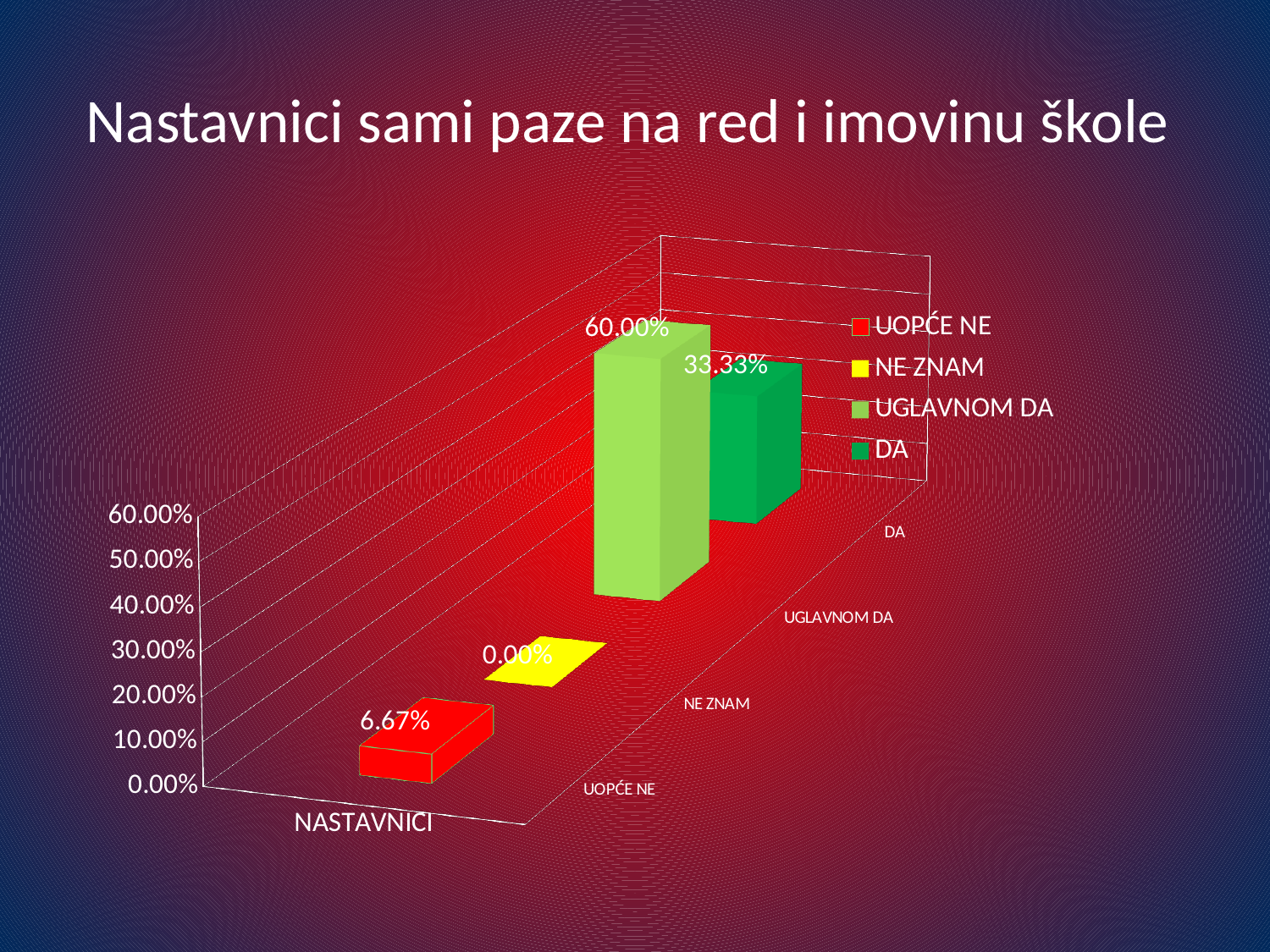
What is the value for UOPĆE NE? 6.67% What is the title of the chart? Nastavnici sami paze na red i imovinu škole Which series has the lowest value? NE ZNAM Which series has the highest value? UGLAVNOM DA What is the value for UGLAVNOM DA? 60.00% What is the difference between the values for UGLAVNOM DA and DA? 26.67% How many series does the legend list? 4 What is the value for NE ZNAM? 0.00% Is the value for DA greater or less than 40.00%? less What is the value for DA? 33.33% Which is larger, the value for DA or the value for UOPĆE NE? DA What kind of chart is shown on the slide? bar chart